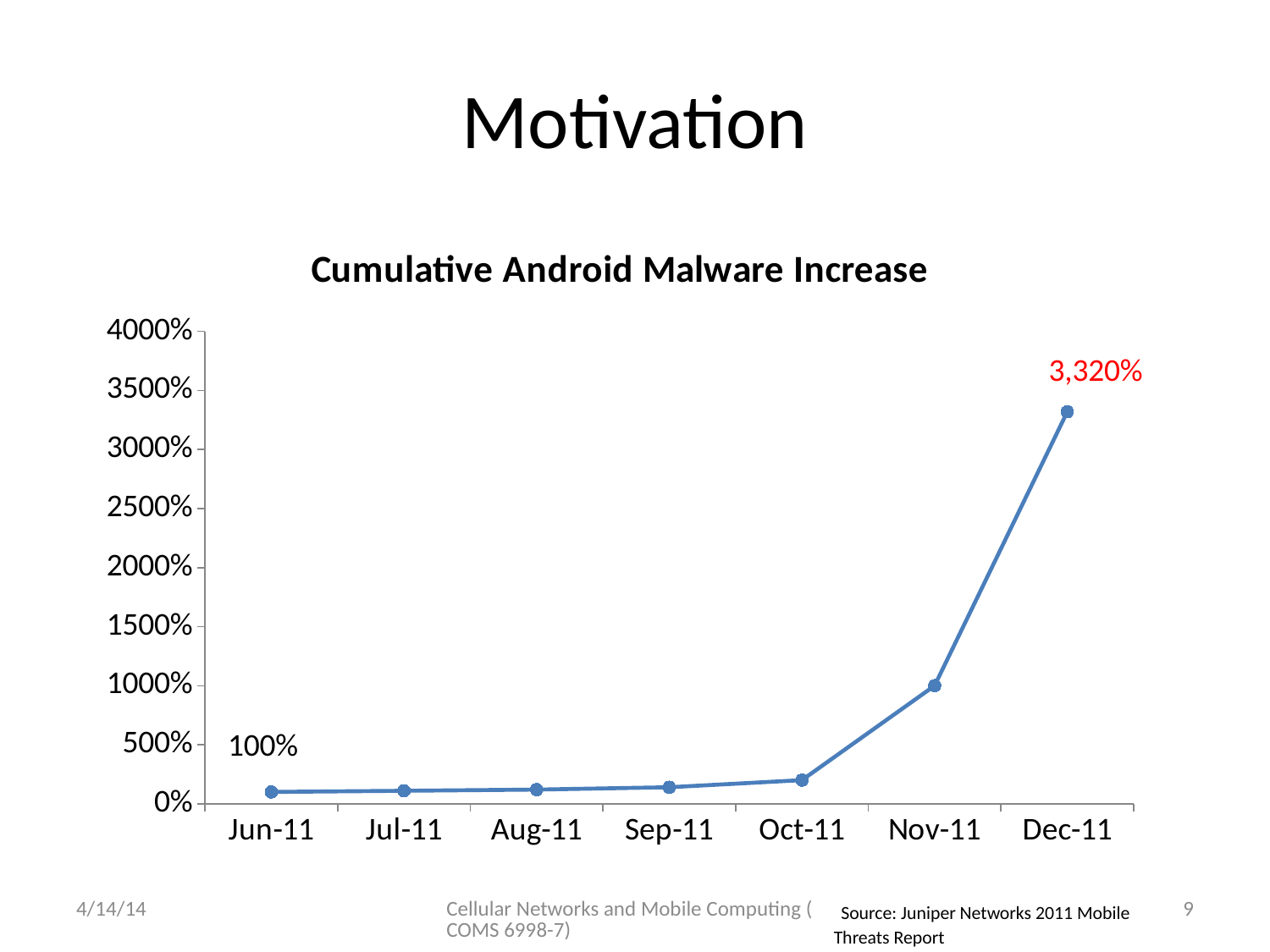
Which month has the lowest value? Jun-11 What is the value for Jun-11? 100% Is the value for Nov-11 greater or less than 500%? greater How many months are plotted on the x axis? 7 What is the difference between the values for Dec-11 and Jun-11? 3,220% What is the title of the chart? Cumulative Android Malware Increase What is the value for Dec-11? 3,320% Is the value for Oct-11 greater or less than 500%? less Do the values rise or fall from Jun-11 to Dec-11? rise Which month has the highest value? Dec-11 What kind of chart is shown on the slide? line chart Which is larger, the value for Nov-11 or the value for Oct-11? Nov-11